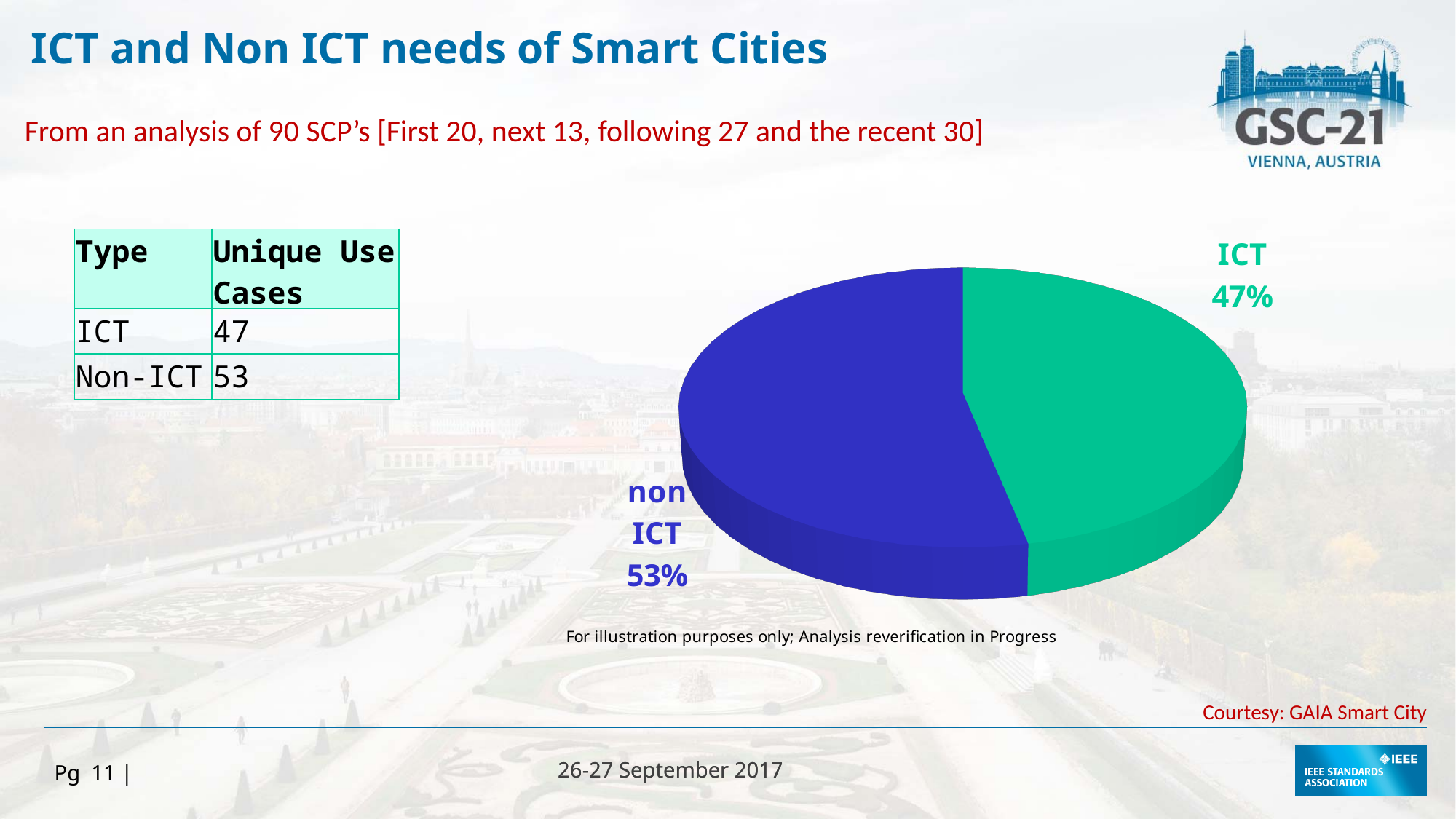
What colour is the ICT slice of the pie chart? green Which slice of the pie is the smallest? ICT What share of the pie does the ICT slice represent? 47% What is the difference in percentage points between the non ICT slice and the ICT slice? 6 What share of the pie does the non ICT slice represent? 53% Which is larger, the ICT slice or the non ICT slice? non ICT What colour is the non ICT slice of the pie chart? blue How many slices does the pie chart have? 2 According to the table, how many unique use cases are ICT? 47 Which slice of the pie is the largest? non ICT According to the table, how many unique use cases are Non-ICT? 53 What kind of chart is shown on the slide? pie chart